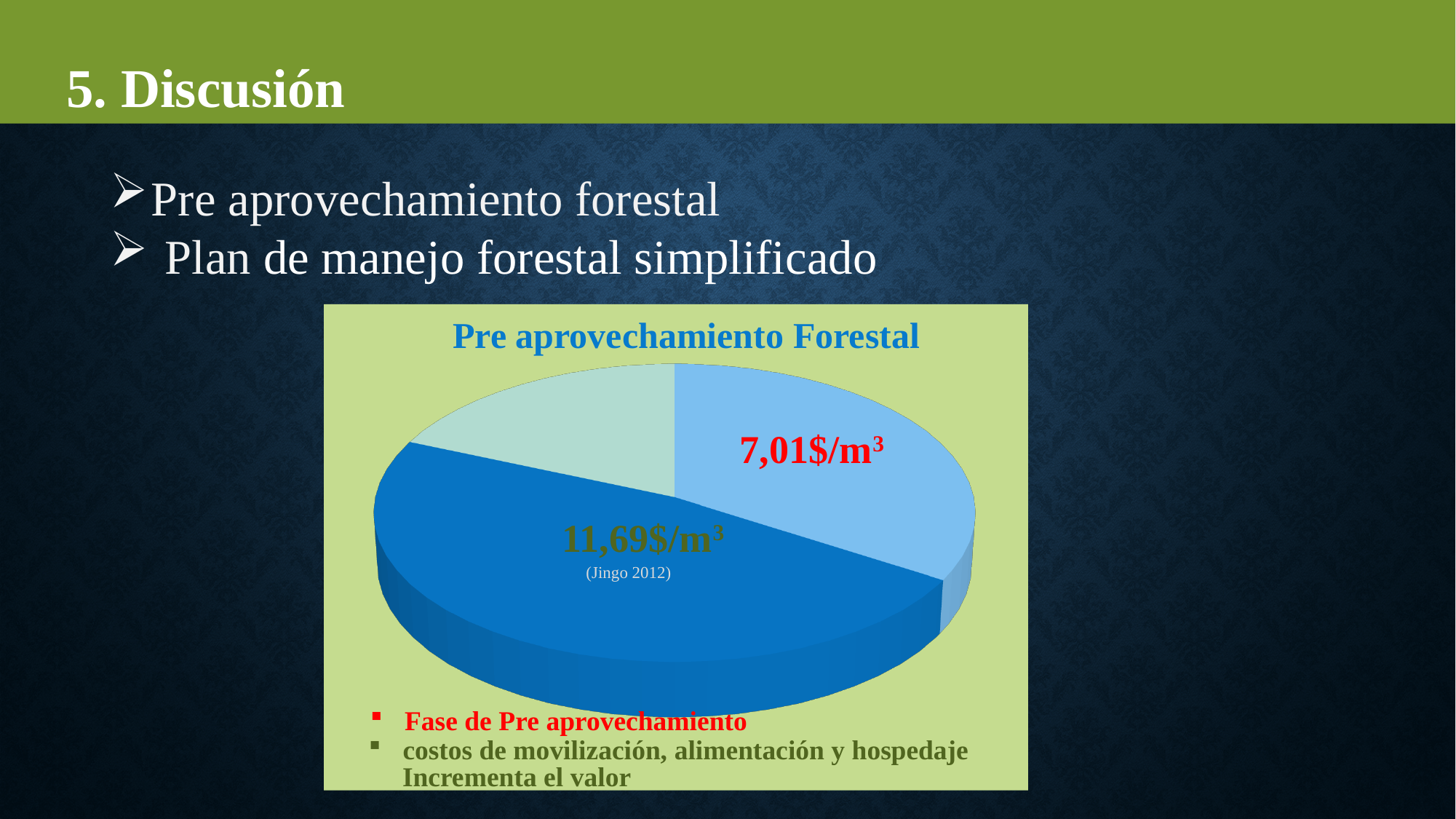
What source citation is printed under the 11,69$/m³ label in the pie chart? (Jingo 2012) What is the difference between the two labelled values in the pie chart, 11,69$/m³ and 7,01$/m³? 4,68$/m³ What value is printed on the light blue slice of the pie chart? 7,01$/m³ What kind of chart is shown on the slide? Pie chart Which slice of the pie chart is the largest? The dark blue slice (11,69$/m³) What is the title of the chart? Pre aprovechamiento Forestal What value is printed on the dark blue slice of the pie chart? 11,69$/m³ Which of the two labelled values in the pie chart is larger, 7,01$/m³ or 11,69$/m³? 11,69$/m³ How many slices of the pie chart have a value label printed on them? 2 How many slices does the pie chart have? 3